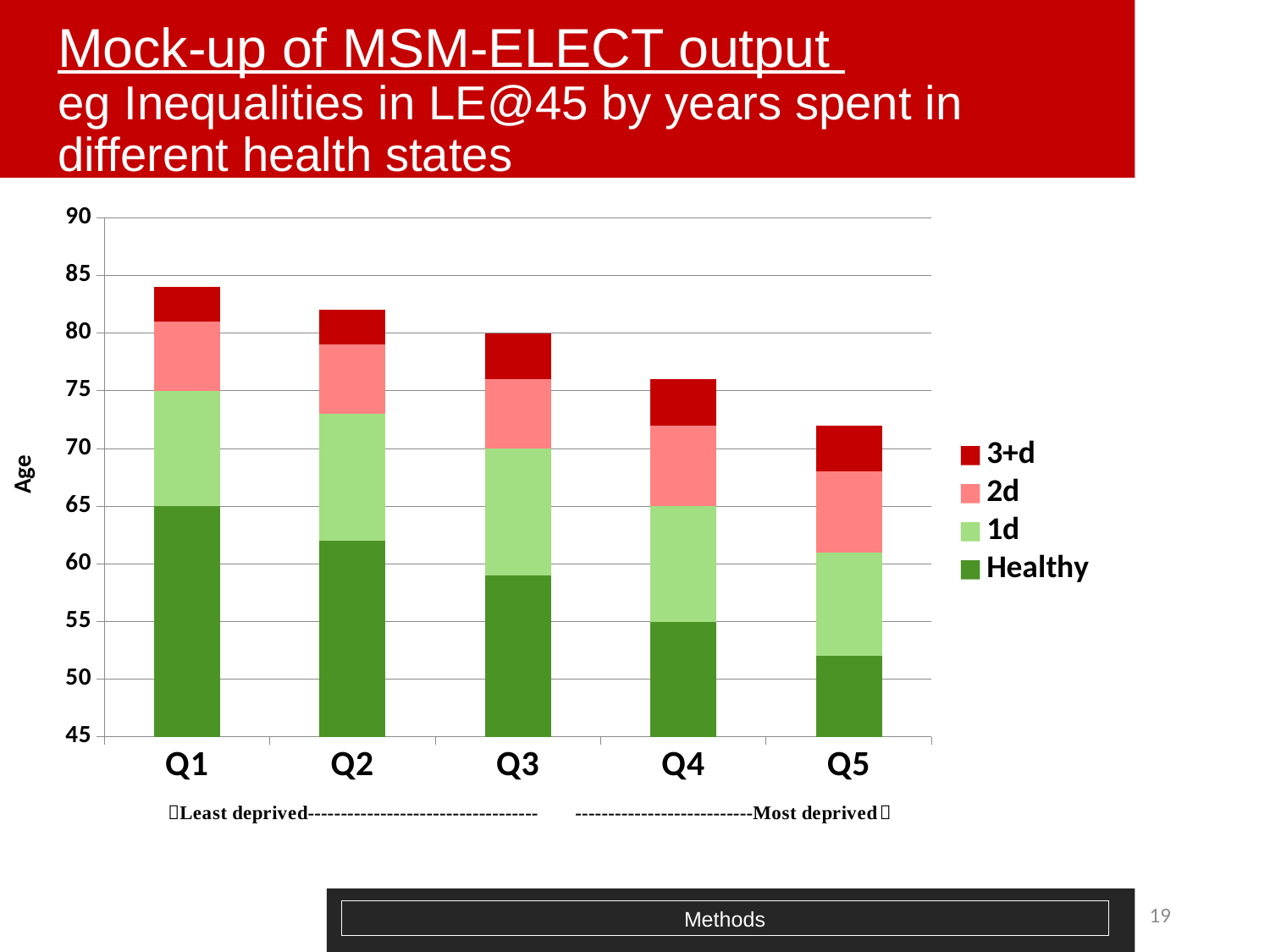
Which category has the tallest total bar? Q1 Which bar has the larger Healthy segment, Q1 or Q5? Q1 Which category has the shortest total bar? Q5 Which legend entry is shown in dark red? 3+d How many categories are shown on the x axis? 5 How many series does the legend list? 4 Is the top of the Healthy segment for Q5 greater or less than 55? less Is the top of the Q5 bar greater or less than 75? less Do the total bar heights rise or fall from Q1 to Q5? fall Is the top of the Q1 bar greater or less than 80? greater What is the label of the y axis? Age What kind of chart is shown on the slide? stacked bar chart